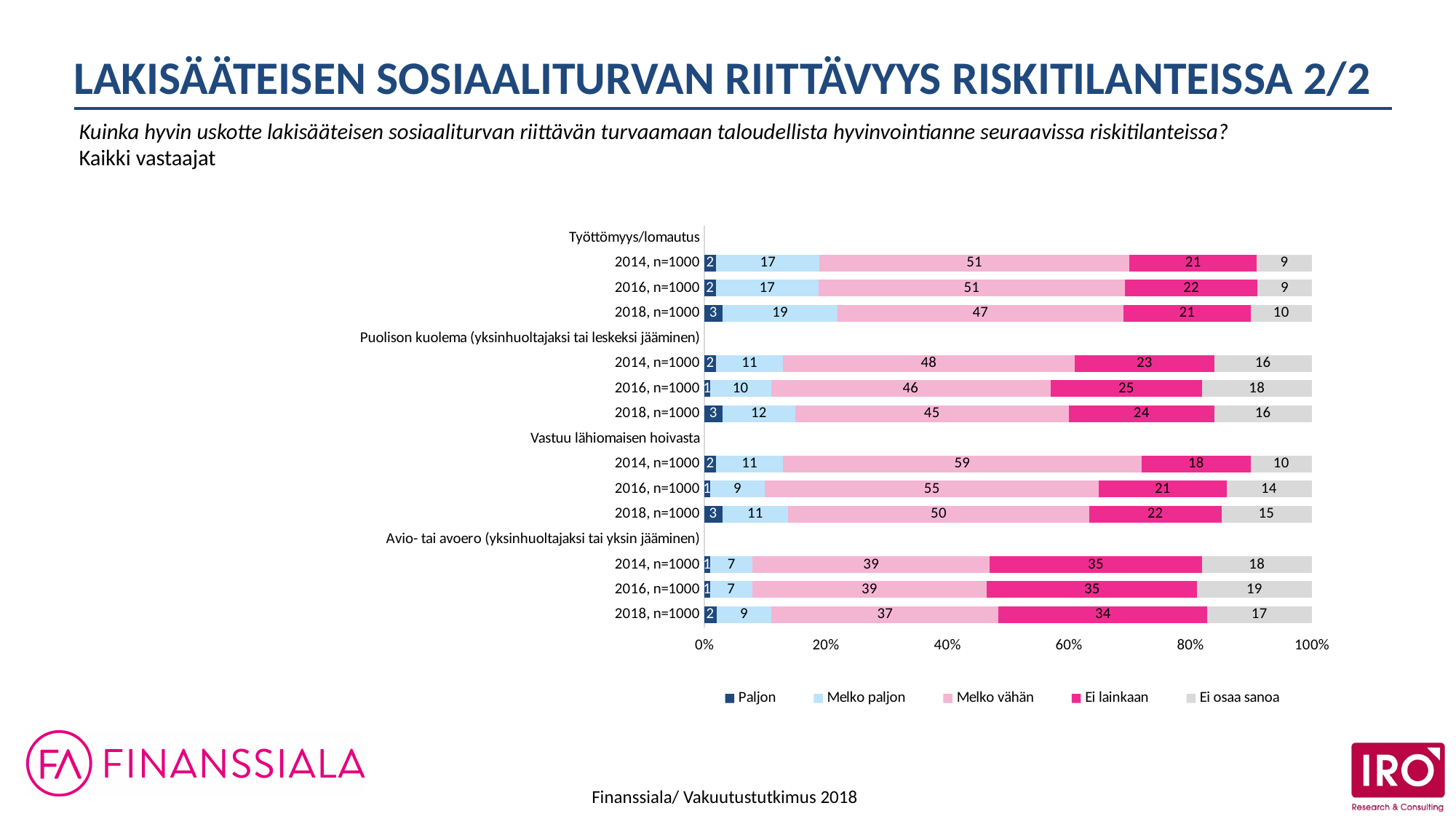
How many series does the legend list? 5 How does the "Melko vähän" value for Vastuu lähiomaisen hoivasta change from 2014 to 2018? It falls What is the total of the stacked bar for Työttömyys/lomautus, 2014, n=1000? 100 Which has the larger "Melko paljon" value in 2018: Työttömyys/lomautus or Puolison kuolema? Työttömyys/lomautus What is the value of "Ei lainkaan" for Avio- tai avoero (yksinhuoltajaksi tai yksin jääminen) in 2016, n=1000? 35 What is the value of "Melko vähän" for Työttömyys/lomautus in 2014, n=1000? 51 What is the difference between the "Ei lainkaan" value for Avio- tai avoero in 2014 and the "Ei lainkaan" value for Työttömyys/lomautus in 2014? 14 How many bars are plotted in the chart? 12 Which bar has the highest "Melko vähän" value? Vastuu lähiomaisen hoivasta, 2014, n=1000 What kind of chart is shown on the slide? Stacked bar chart Which bar has the lowest "Ei lainkaan" value? Vastuu lähiomaisen hoivasta, 2014, n=1000 What is the value of "Ei osaa sanoa" for Puolison kuolema (yksinhuoltajaksi tai leskeksi jääminen) in 2016, n=1000? 18